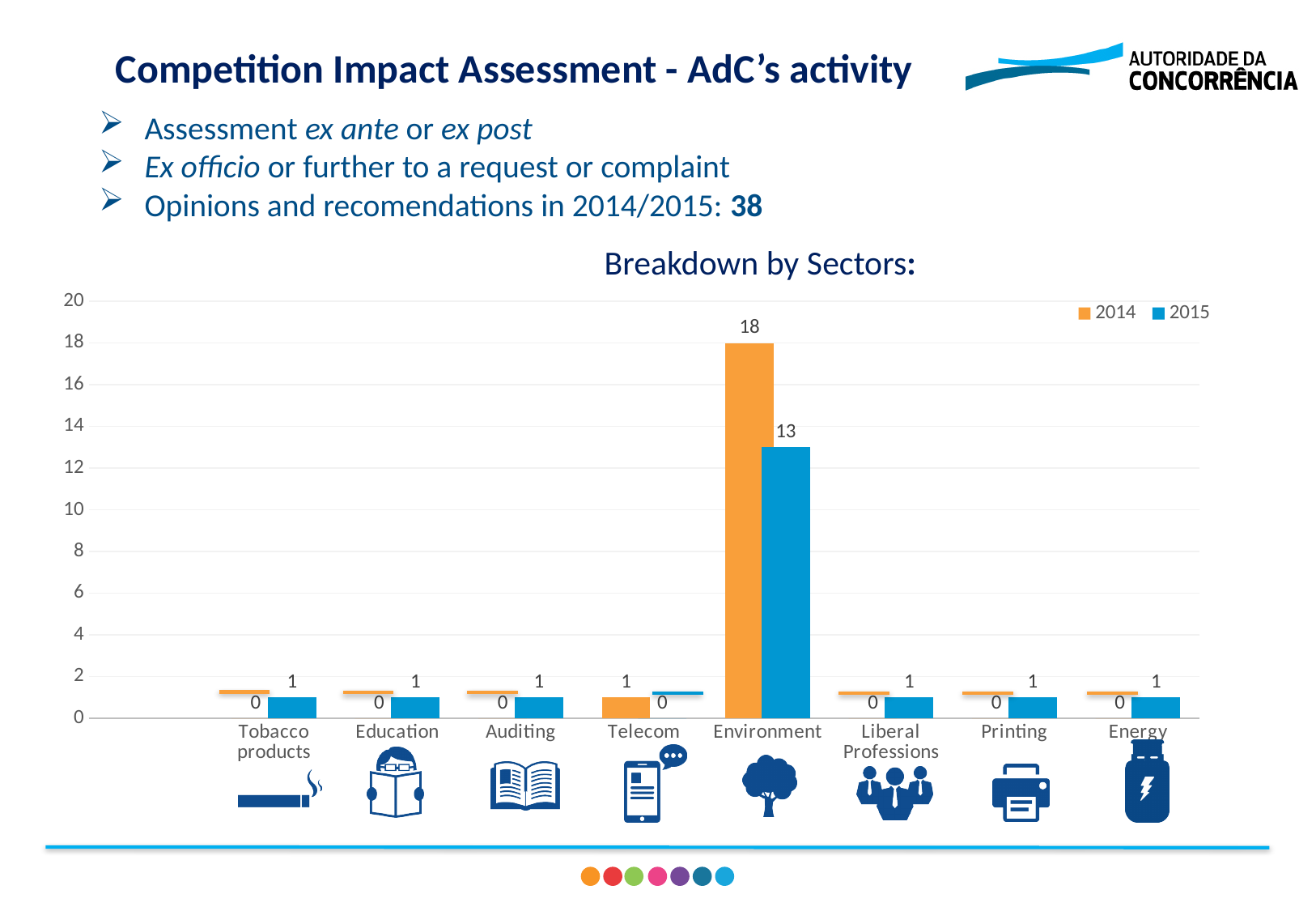
What is the 2014 value for Environment? 18 What is the 2014 value for Telecom? 1 What is the title of the chart? Breakdown by Sectors: How many series does the legend list? 2 Which sector has the highest 2014 value? Environment Which is larger for Environment, the 2014 value or the 2015 value? 2014 What is the 2015 value for Telecom? 0 What is the 2015 value for Printing? 1 What is the 2015 value for Environment? 13 How many sectors are shown on the x axis? 8 What is the difference between the 2014 and 2015 values for Environment? 5 What kind of chart is shown? Bar chart